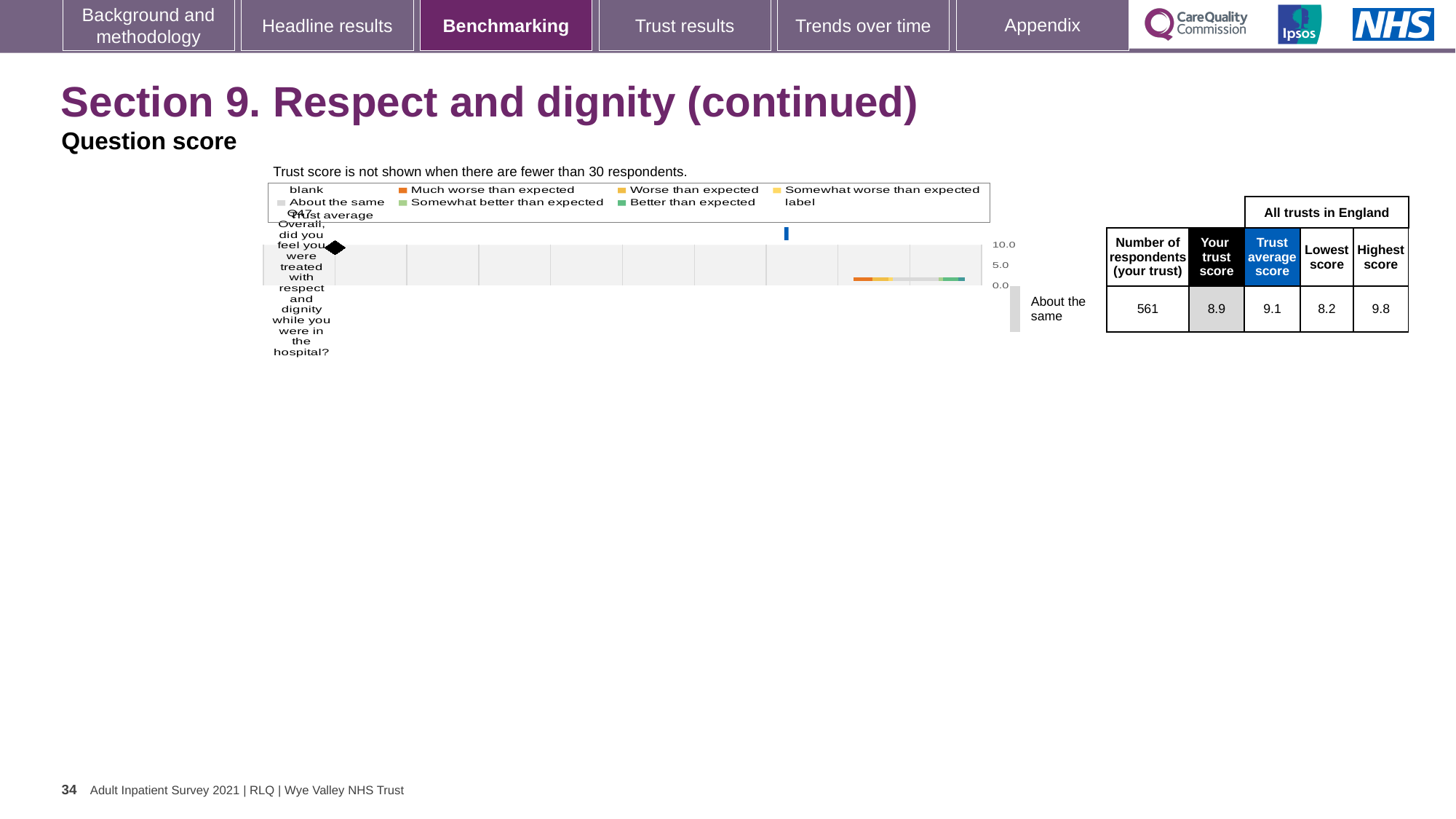
How many respondents from the trust answered Q47? 561 How many survey questions are plotted on the chart? 1 What is the difference between the highest and lowest scores for Q47 across all trusts in England? 1.6 What is the trust average score for Q47 across all trusts in England? 9.1 What is the highest score among all trusts in England for Q47? 9.8 What is the trust score for Q47 shown in the 'Your trust score' column? 8.9 Is your trust score for Q47 greater or less than 5.0? greater What kind of chart is used to show the Q47 benchmarking result? Bar chart What is the difference between the trust average score and your trust score for Q47? 0.2 Which is larger for Q47: your trust score or the trust average score? Trust average score What benchmarking category is shown next to the chart for Q47? About the same What is the lowest score among all trusts in England for Q47? 8.2